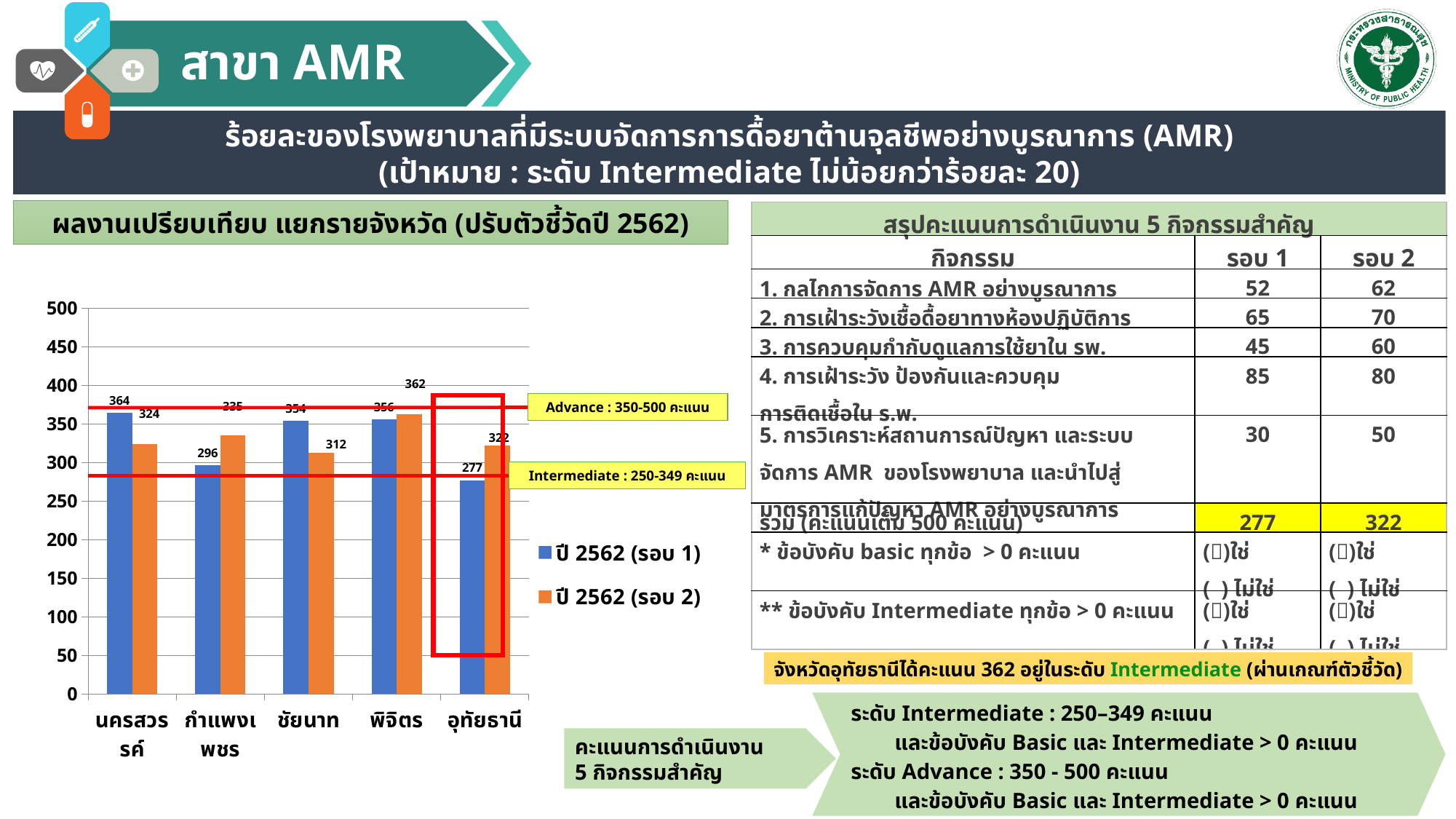
What type of chart is shown on the slide? bar chart What is the difference between the ปี 2562 (รอบ 1) and ปี 2562 (รอบ 2) values for ชัยนาท? 42 For นครสวรรค์, which series has the larger value, ปี 2562 (รอบ 1) or ปี 2562 (รอบ 2)? ปี 2562 (รอบ 1) How many provinces are shown on the x axis of the chart? 5 Is the ปี 2562 (รอบ 1) value for กำแพงเพชร greater or less than 300? less Which province has the highest value in the ปี 2562 (รอบ 2) series? พิจิตร How many series does the chart legend list? 2 What is the value for นครสวรรค์ in the ปี 2562 (รอบ 1) series? 364 Which province has the lowest value in the ปี 2562 (รอบ 1) series? อุทัยธานี What is the difference between the ปี 2562 (รอบ 2) and ปี 2562 (รอบ 1) values for อุทัยธานี? 45 What is the value for อุทัยธานี in the ปี 2562 (รอบ 2) series? 322 What is the value for กำแพงเพชร in the ปี 2562 (รอบ 2) series? 335